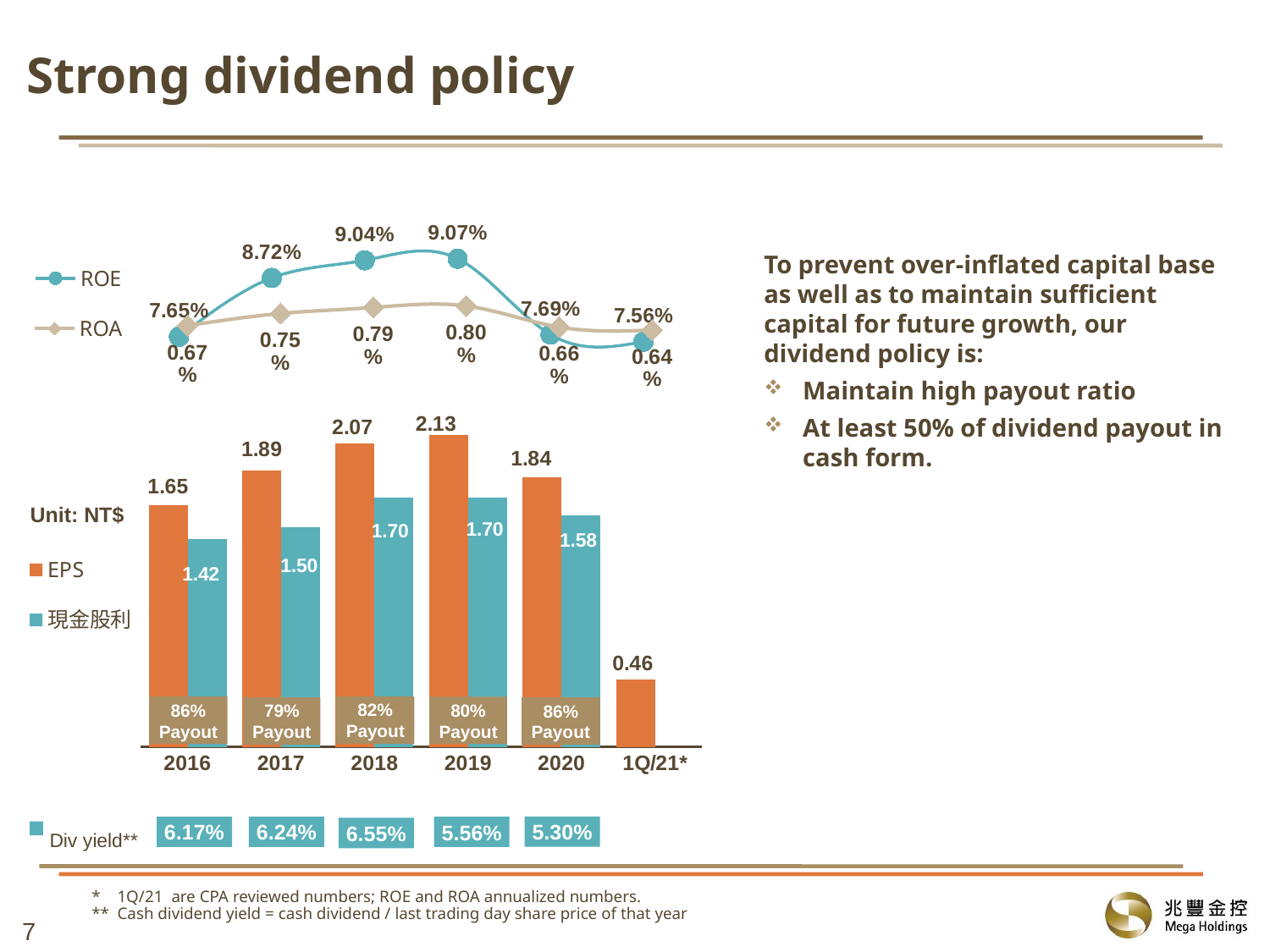
In the bar chart, how many series does the legend list? 2 In the bar chart, what is the difference between EPS and cash dividend in 2018? 0.37 In the line chart, what is the ROA value for 2020? 0.66% In the line chart, which year has the highest ROA? 2019 What type of chart is the lower chart showing EPS and cash dividend? Bar chart In the line chart, what is the ROE value for 2019? 9.07% In the bar chart, what is the cash dividend (現金股利) value for 2017? 1.50 In the bar chart, what is the payout ratio shown for 2017? 79% In the bar chart, what is the EPS value for 2019? 2.13 In the bar chart, which year has the lowest cash dividend (現金股利)? 2016 In the bar chart, which year has the highest EPS? 2019 In the bar chart, which is larger: the EPS for 2017 or the EPS for 2020? 2017